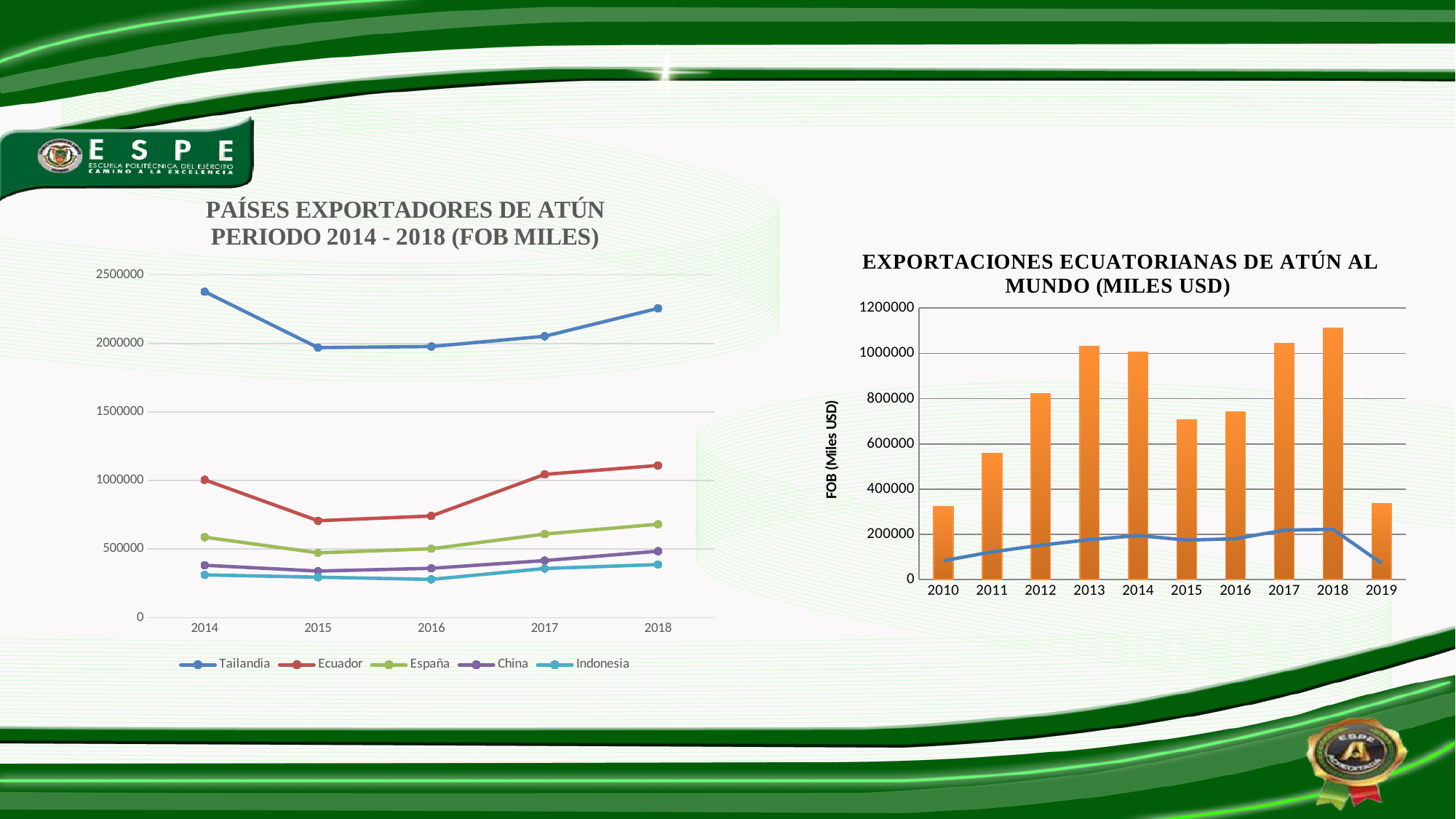
In the chart titled 'PAÍSES EXPORTADORES DE ATÚN PERIODO 2014 - 2018 (FOB MILES)', is the value for Ecuador in 2015 greater or less than 1000000? less In the chart titled 'PAÍSES EXPORTADORES DE ATÚN PERIODO 2014 - 2018 (FOB MILES)', what kind of chart is it? line chart In the chart titled 'PAÍSES EXPORTADORES DE ATÚN PERIODO 2014 - 2018 (FOB MILES)', is the value for Tailandia in 2014 greater or less than 2000000? greater In the chart titled 'PAÍSES EXPORTADORES DE ATÚN PERIODO 2014 - 2018 (FOB MILES)', which country has the lowest value in 2016? Indonesia In the chart titled 'PAÍSES EXPORTADORES DE ATÚN PERIODO 2014 - 2018 (FOB MILES)', how many years are shown on the x axis? 5 In the chart titled 'PAÍSES EXPORTADORES DE ATÚN PERIODO 2014 - 2018 (FOB MILES)', how many series does the legend list? 5 In the chart titled 'EXPORTACIONES ECUATORIANAS DE ATÚN AL MUNDO (MILES USD)', which year has the shortest bar? 2010 In the chart titled 'EXPORTACIONES ECUATORIANAS DE ATÚN AL MUNDO (MILES USD)', which year has the tallest bar? 2018 In the chart titled 'EXPORTACIONES ECUATORIANAS DE ATÚN AL MUNDO (MILES USD)', what kind of chart is used for the orange series? bar chart In the chart titled 'EXPORTACIONES ECUATORIANAS DE ATÚN AL MUNDO (MILES USD)', what is the label of the vertical axis? FOB (Miles USD) In the chart titled 'PAÍSES EXPORTADORES DE ATÚN PERIODO 2014 - 2018 (FOB MILES)', which is larger in 2018, Ecuador or España? Ecuador In the chart titled 'PAÍSES EXPORTADORES DE ATÚN PERIODO 2014 - 2018 (FOB MILES)', which country has the highest values across the whole period? Tailandia